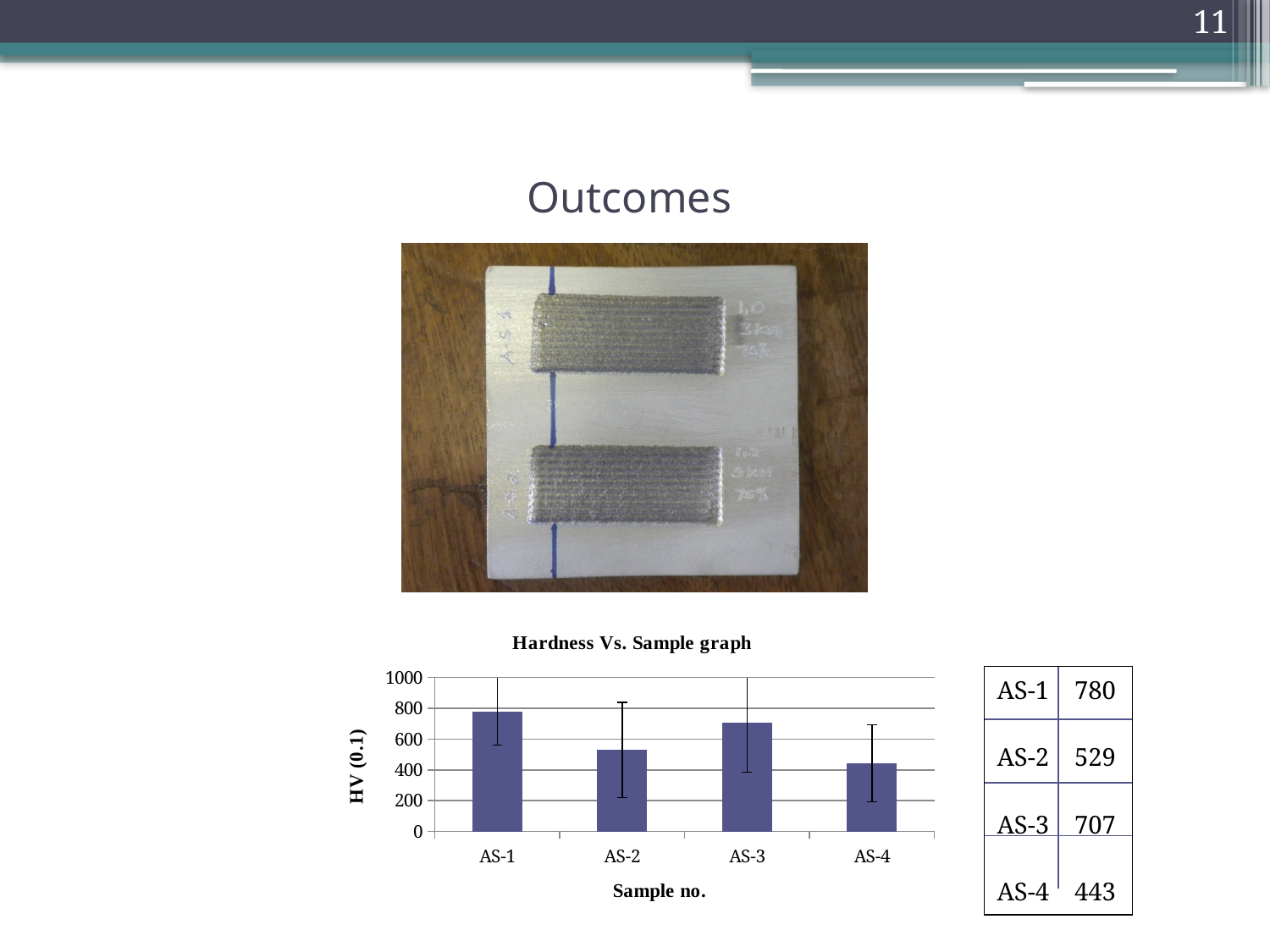
How many samples are plotted on the x axis of the chart? 4 Which sample has a larger hardness value, AS-2 or AS-3? AS-3 What is the difference in hardness between AS-3 and AS-4? 264 What is the title of the chart? Hardness Vs. Sample graph What type of chart is shown on the slide? bar chart What is the hardness value (HV 0.1) for sample AS-1? 780 Is the value for AS-4 greater or less than 600? less What is the hardness value (HV 0.1) for sample AS-4? 443 What is the difference in hardness between AS-1 and AS-2? 251 Which sample has the lowest hardness value? AS-4 What is the label of the y axis of the chart? HV (0.1) Which sample has the highest hardness value? AS-1